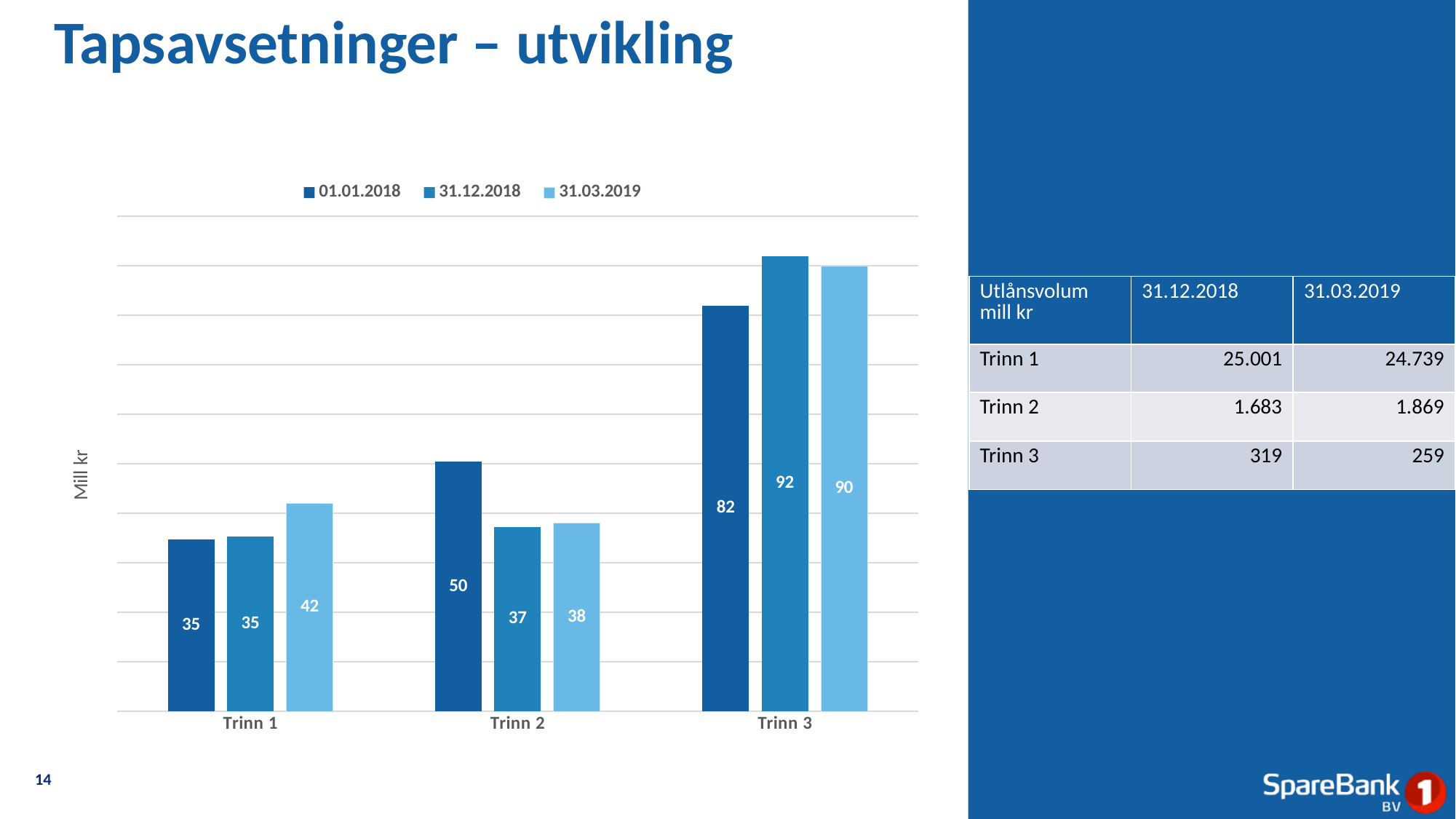
What is the value for Trinn 2 in the 01.01.2018 series? 50 What is the value for Trinn 1 in the 31.03.2019 series? 42 What is the value for Trinn 3 in the 31.12.2018 series? 92 What is the difference between the 31.12.2018 and 01.01.2018 values for Trinn 3? 10 What kind of chart is shown on the slide? Bar chart How many series does the chart legend list? 3 Which category has the highest value in the 31.03.2019 series? Trinn 3 How many categories are shown on the x axis of the chart? 3 Which is larger for Trinn 3: the 31.12.2018 value or the 31.03.2019 value? 31.12.2018 What is the difference between the 01.01.2018 and 31.12.2018 values for Trinn 2? 13 What is the label on the vertical axis of the chart? Mill kr Which category has the lowest value in the 01.01.2018 series? Trinn 1